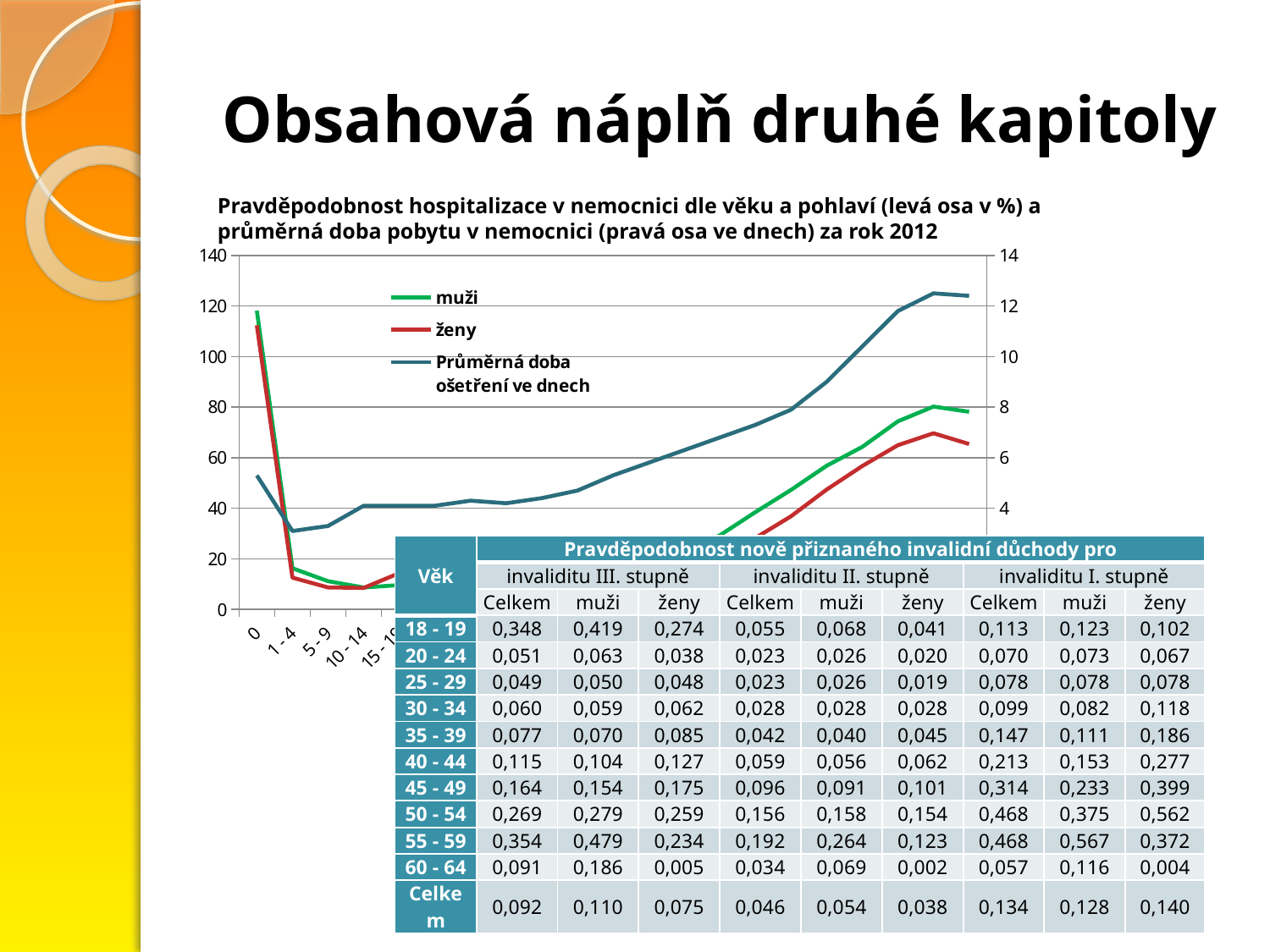
Which series in the chart is drawn in green? muži On the right axis, is the value for Průměrná doba ošetření ve dnech at age category 0 greater or less than 6? less What kind of chart is shown on the slide? line chart Does the Průměrná doba ošetření ve dnech series generally rise or fall across the age categories after 1 - 4? rise Which age category has the highest value for muži? 0 Is the value for muži at age category 0 greater or less than 100? greater On the right axis, is the value for Průměrná doba ošetření ve dnech at age category 1 - 4 greater or less than 4? less What are the three series named in the chart legend? muži, ženy, Průměrná doba ošetření ve dnech How many series does the chart legend list? 3